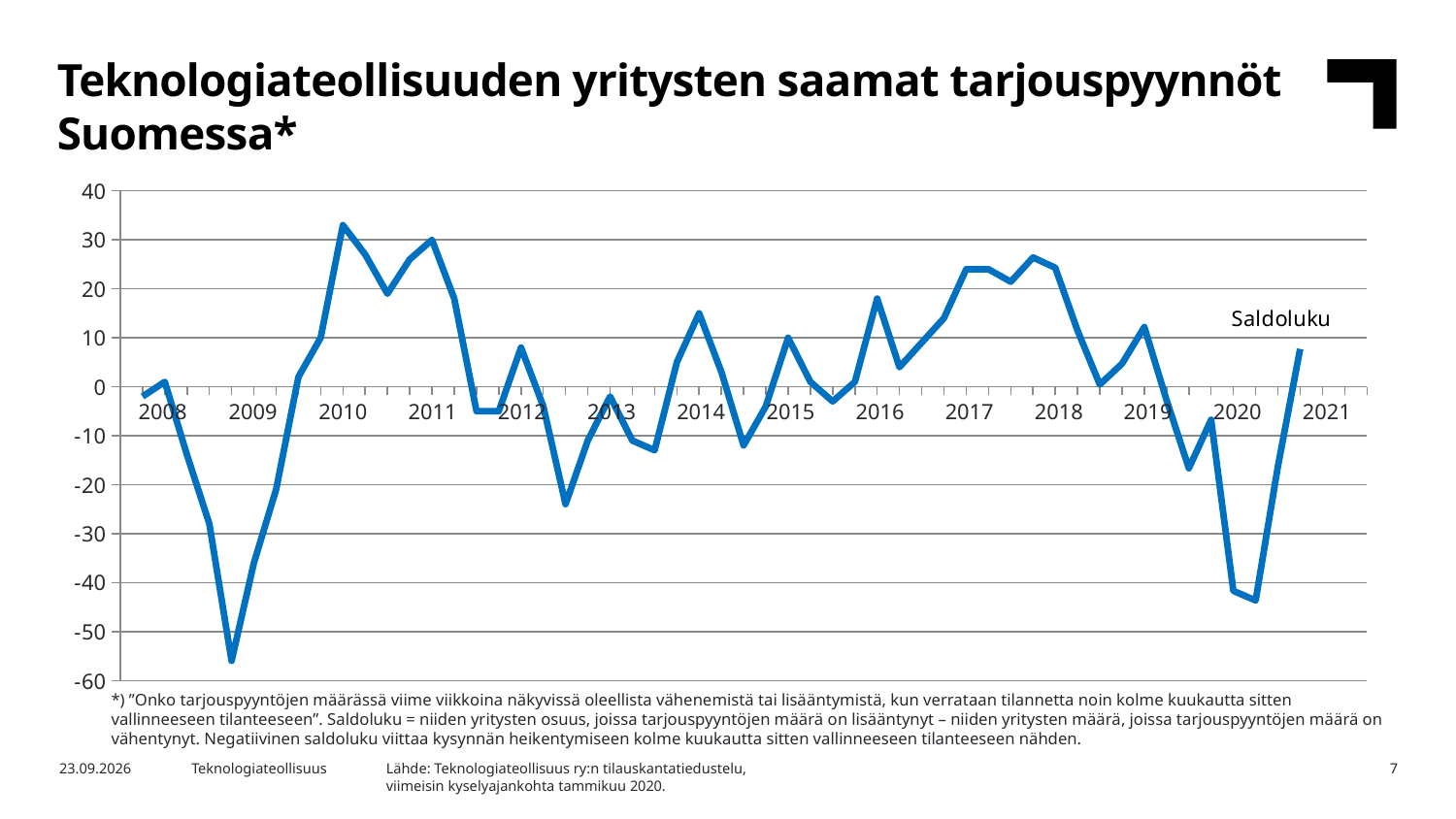
Is the peak value of the line around 2018 greater or less than 20? greater In which year does the line reach its lowest point? 2009 Is the peak value of the line in 2010 greater or less than 20? greater What is the title of the chart on the slide? Teknologiateollisuuden yritysten saamat tarjouspyynnöt Suomessa* How many year labels are shown on the x axis of the chart? 14 What kind of chart is shown on the slide? line chart Does the line rise or fall between the start of 2008 and the low point in 2009? fall Is the lowest value of the line, in 2009, greater or less than -50? less Does the line rise or fall from its low point in 2020 to the last point in 2021? rise What is the name of the series plotted in the chart? Saldoluku